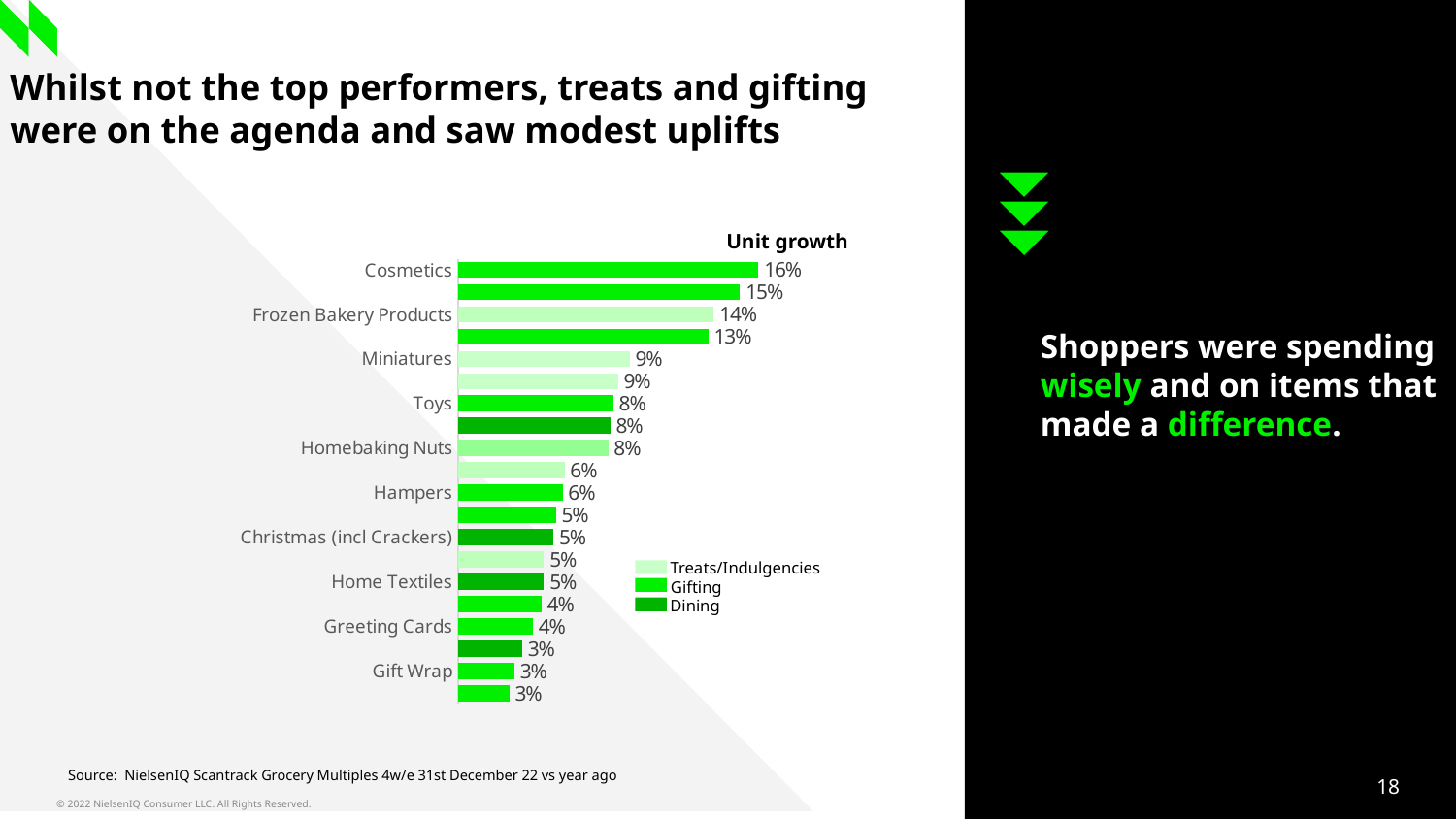
What kind of chart is shown on the slide? Bar chart What is the unit growth for Miniatures? 9% Which labelled category has the highest unit growth? Cosmetics What is the unit growth for Homebaking Nuts? 8% What is the unit growth for Frozen Bakery Products? 14% According to the legend, which series does the dark green colour represent? Dining What is the unit growth for Greeting Cards? 4% What is the unit growth for Cosmetics? 16% Which has higher unit growth, Toys or Hampers? Toys Do the unit growth values rise or fall going down the chart from Cosmetics to Gift Wrap? Fall What is the difference in unit growth between Cosmetics and Frozen Bakery Products? 2% How many series does the legend list? 3